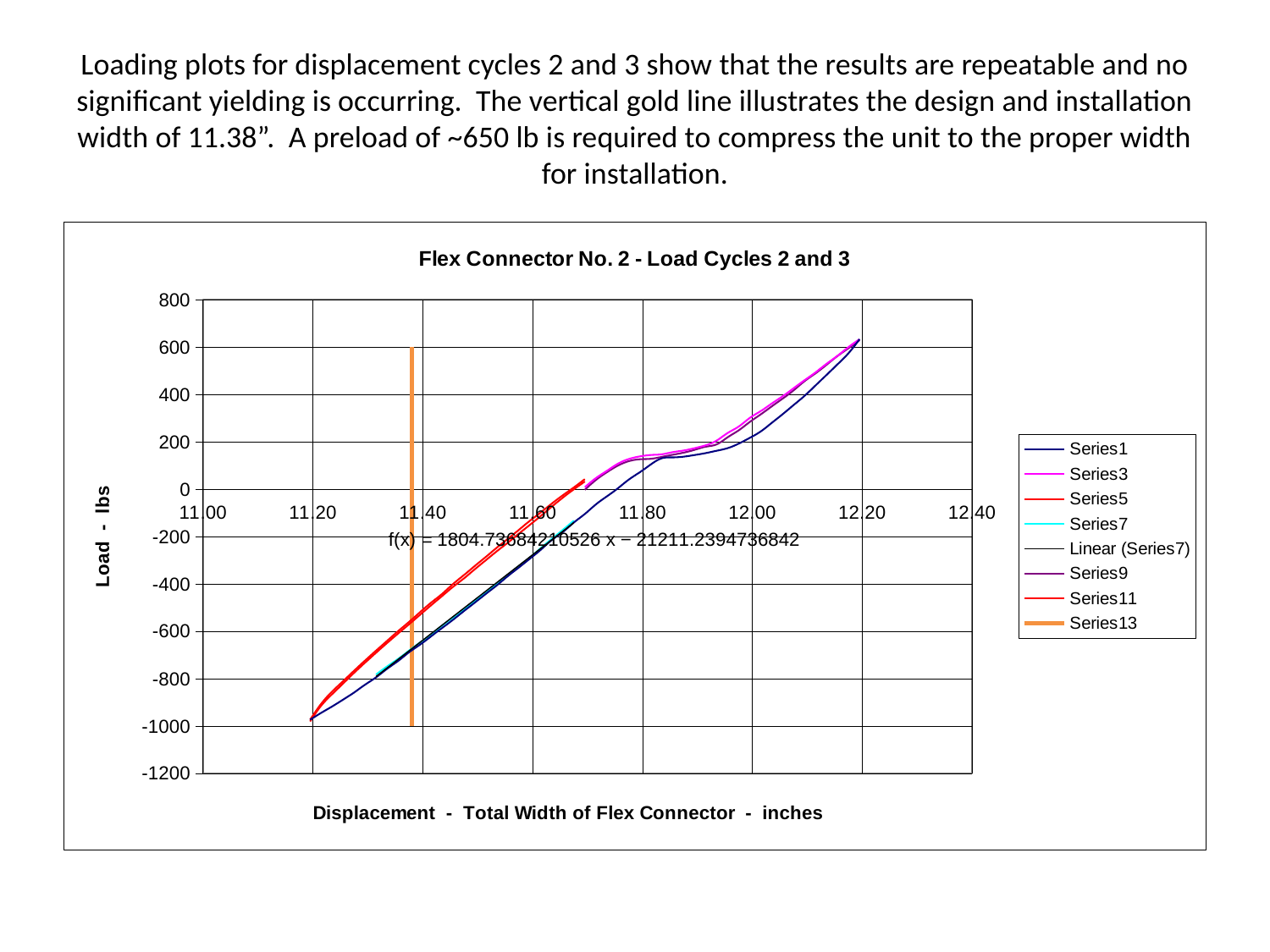
What is the highest value shown on the y axis? 800 How many series does the chart legend list? 8 Do the load values generally rise or fall as displacement increases along the x axis? rise What is the label of the y axis? Load - lbs What is the lowest value shown on the y axis? -1200 Is the load on the curves at a displacement of 11.80 greater or less than 0? greater Is the load on the curves at a displacement of 11.60 greater or less than 0? less Is the load for Series1 at a displacement of 11.20 greater or less than -800? less What is the title of the chart? Flex Connector No. 2 - Load Cycles 2 and 3 What type of chart is shown on the slide? line chart